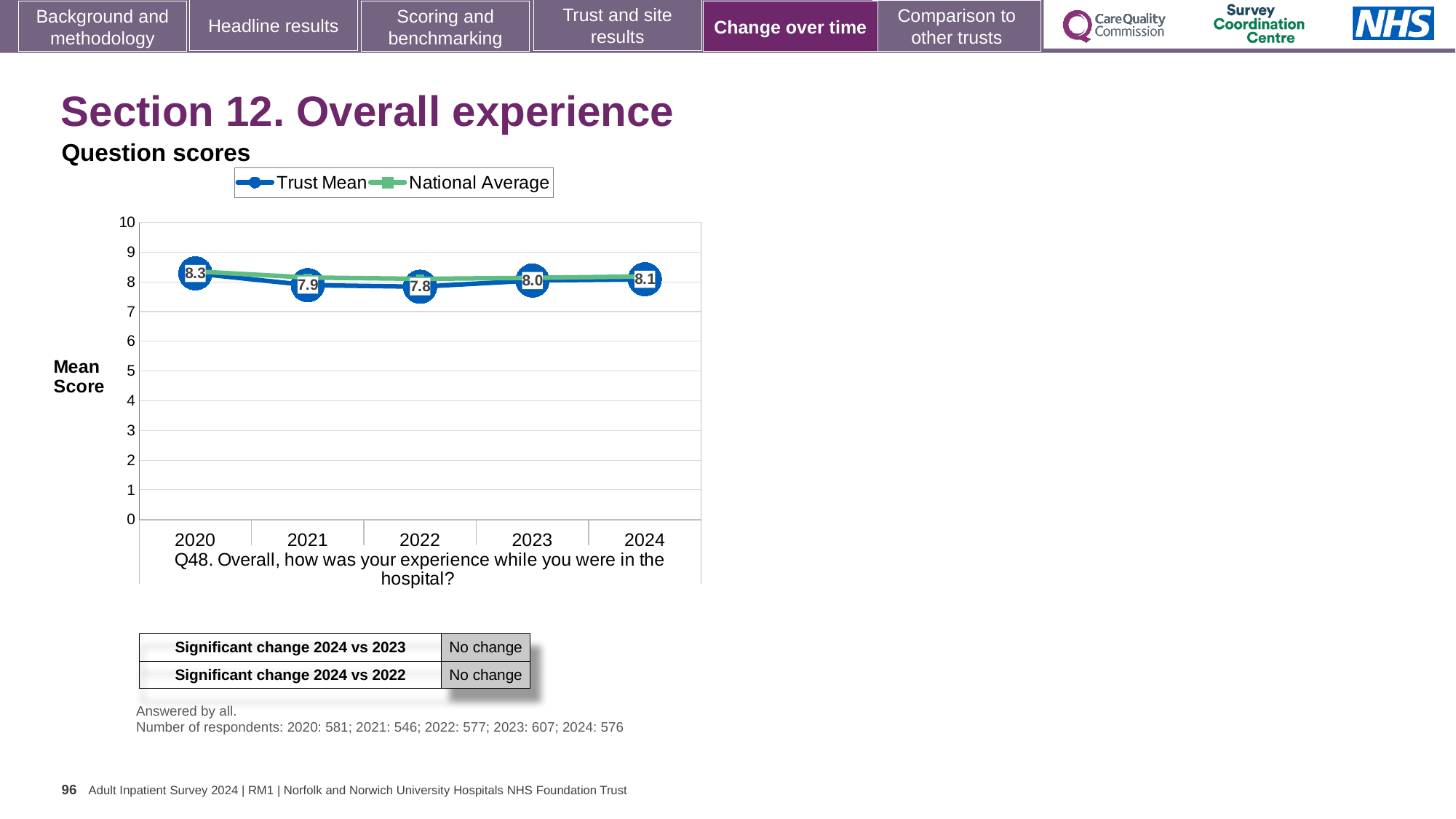
In which year is the Trust Mean score highest? 2020 How many years are shown on the x axis of the chart? 5 What is the difference between the Trust Mean score in 2020 and in 2022? 0.5 What is the Trust Mean score for 2022? 7.8 Which year has the larger Trust Mean score, 2021 or 2024? 2024 In which year is the Trust Mean score lowest? 2022 What kind of chart is shown on the slide? Line chart Is the Trust Mean score for 2023 greater or less than 5? greater What is the Trust Mean score for 2024? 8.1 What is the Trust Mean score for 2020? 8.3 How many series does the chart legend list? 2 Does the Trust Mean score rise or fall from 2022 to 2024? Rise